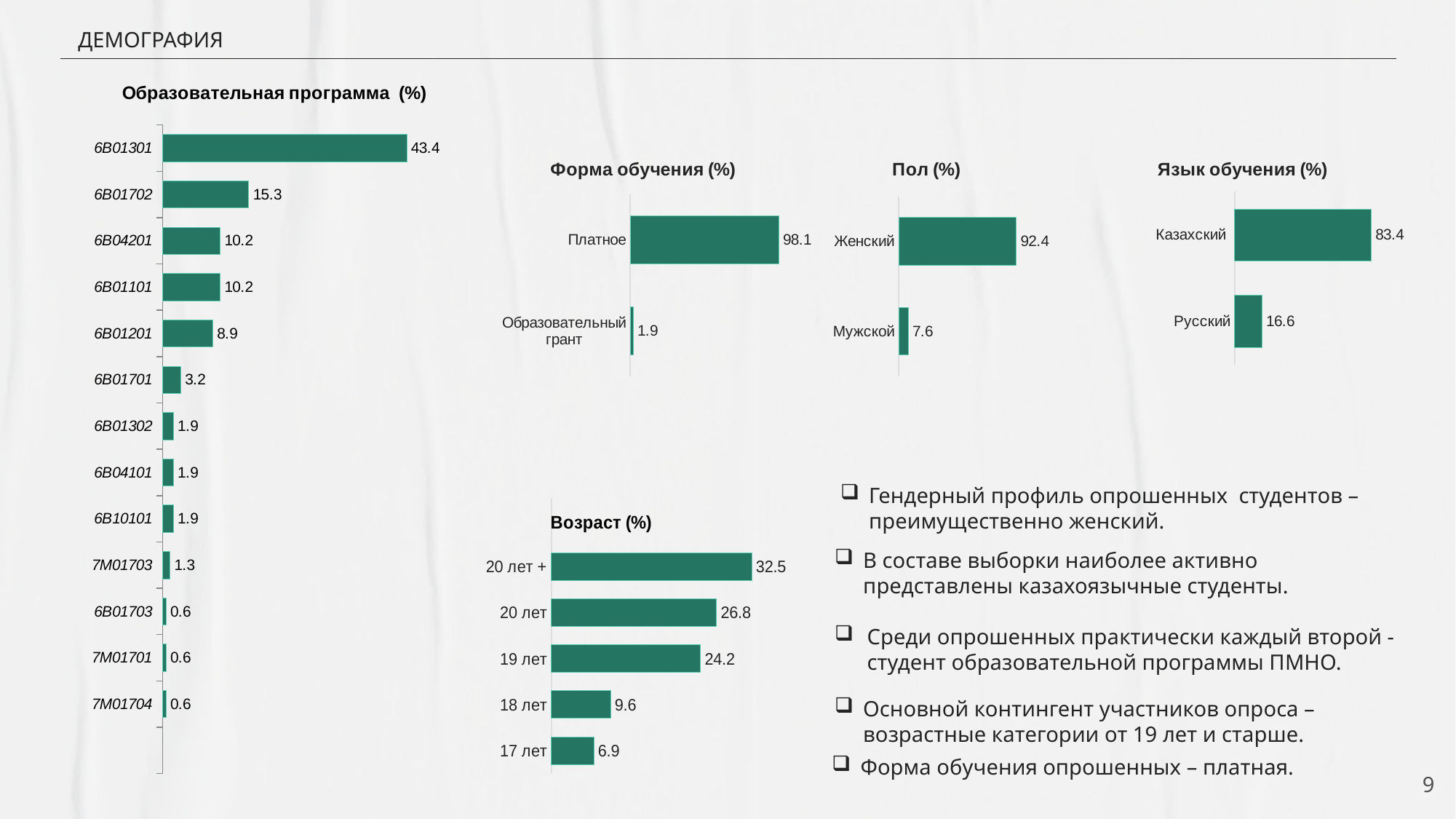
In the 'Образовательная программа (%)' chart, which category has the highest value? 6B01301 What type of chart is the 'Возраст (%)' chart? Bar chart In the 'Пол (%)' chart, what is the value for Мужской? 7.6 In the 'Пол (%)' chart, what is the difference between Женский and Мужской? 84.8 In the 'Образовательная программа (%)' chart, what is the value for 6B01301? 43.4 In the 'Форма обучения (%)' chart, what is the value for Платное? 98.1 In the 'Образовательная программа (%)' chart, what is the difference between 6B01301 and 6B01702? 28.1 In the 'Язык обучения (%)' chart, what is the value for Русский? 16.6 In the 'Возраст (%)' chart, which category has the lowest value? 17 лет In the 'Форма обучения (%)' chart, what is the value for Образовательный грант? 1.9 In the 'Язык обучения (%)' chart, which category is larger, Казахский or Русский? Казахский In the 'Образовательная программа (%)' chart, how many categories are shown? 13